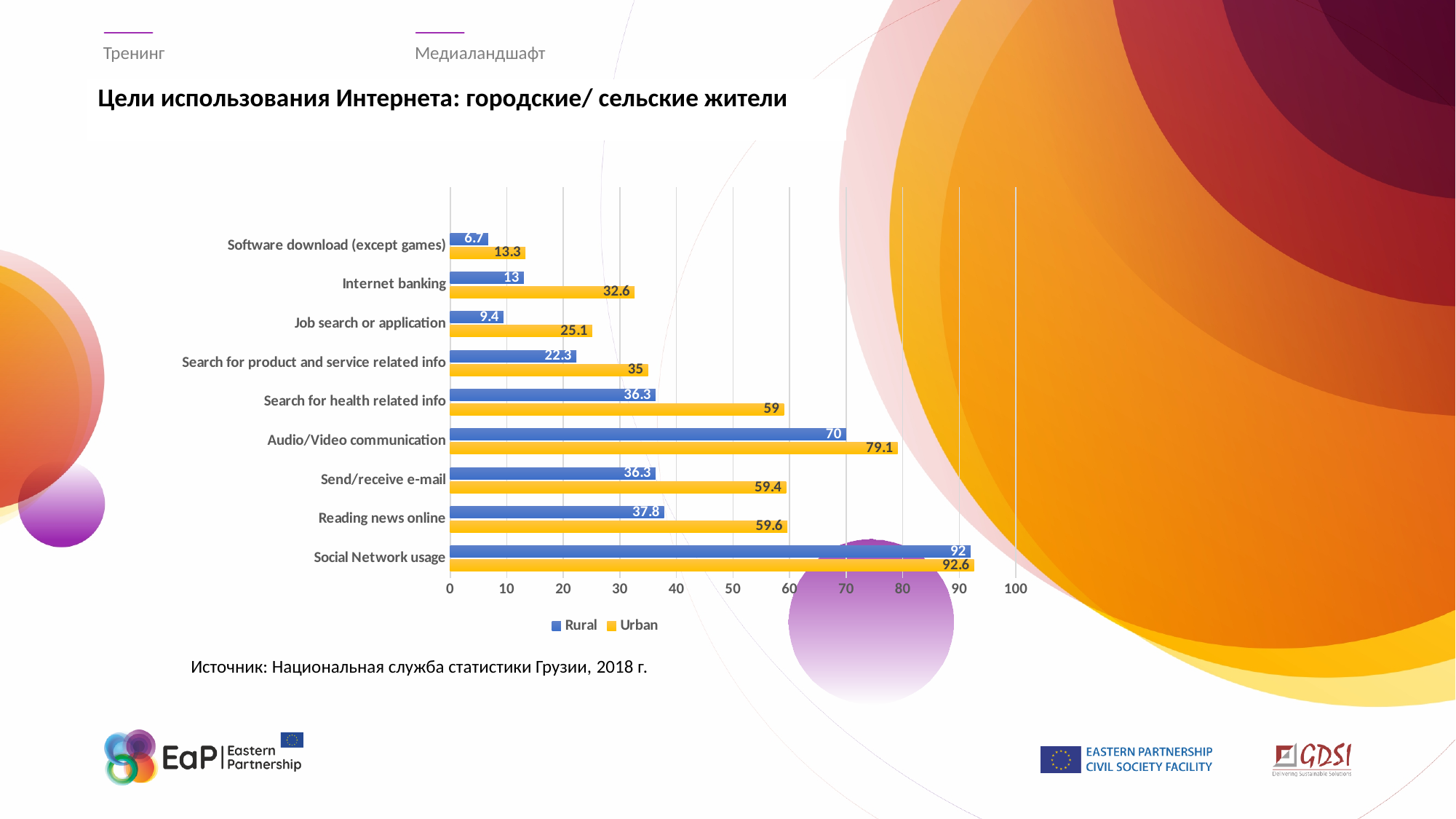
What is the Rural value for Audio/Video communication? 70 What is the difference between the Urban and Rural values for Search for health related info? 22.7 How many categories are shown on the chart? 9 Which category has the lowest Rural value? Software download (except games) Is the Urban value for Reading news online greater or less than 50? greater What is the Rural value for Software download (except games)? 6.7 Which category has the highest Urban value? Social Network usage What kind of chart is shown on the slide? bar chart What is the Urban value for Internet banking? 32.6 Which colour represents the Urban series? yellow How many series does the legend list? 2 Which is larger for Job search or application: the Rural value or the Urban value? Urban